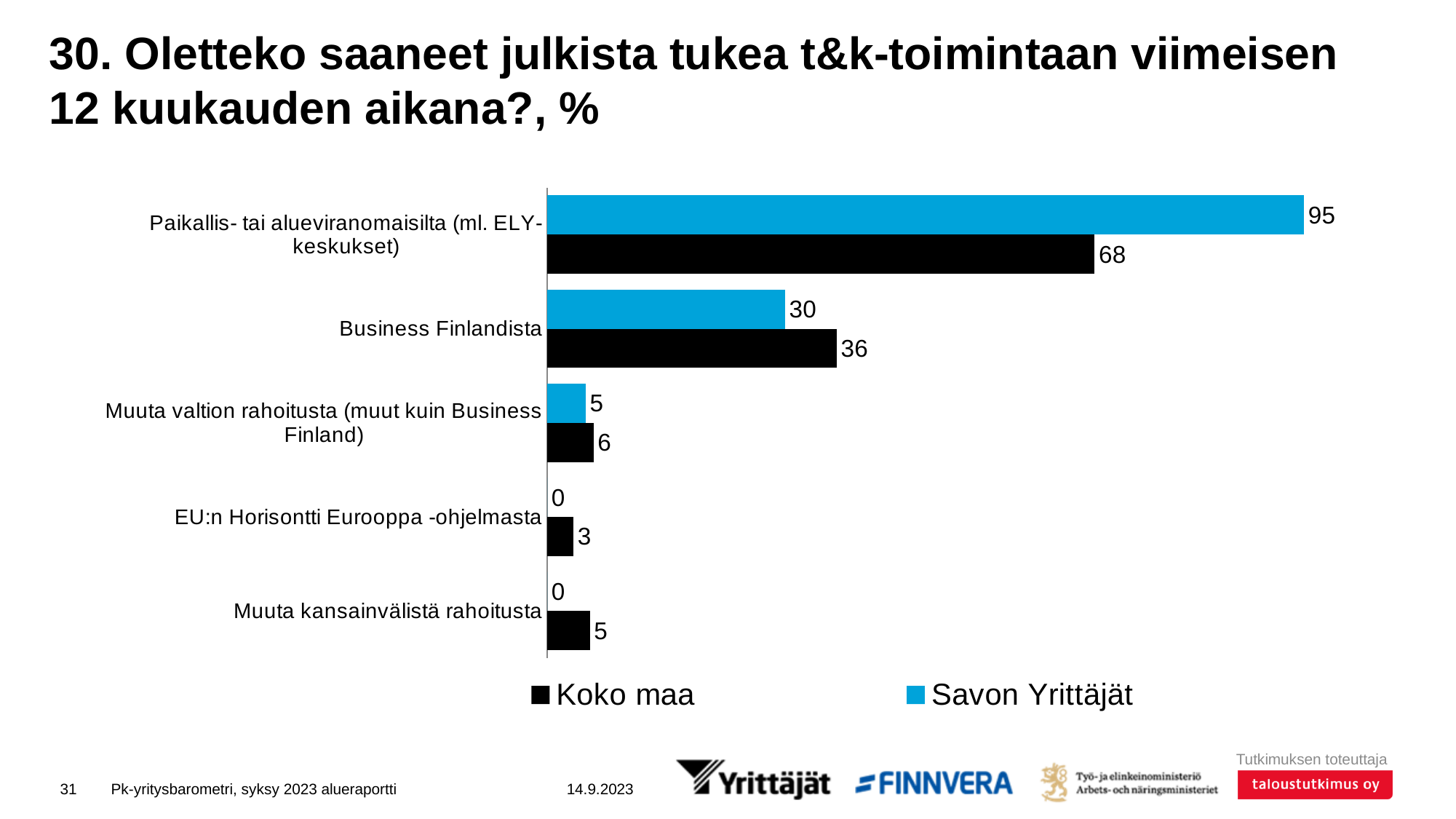
How many series does the legend list? 2 What is the value for Savon Yrittäjät for "EU:n Horisontti Eurooppa -ohjelmasta"? 0 What is the difference between the Savon Yrittäjät and Koko maa values for "Paikallis- tai alueviranomaisilta (ml. ELY-keskukset)"? 27 What is the value for Savon Yrittäjät for "Paikallis- tai alueviranomaisilta (ml. ELY-keskukset)"? 95 What kind of chart is shown on the slide? Bar chart For "Business Finlandista", which series has the larger value, Koko maa or Savon Yrittäjät? Koko maa Which colour represents Savon Yrittäjät in the chart? Blue What is the value for Koko maa for "Muuta kansainvälistä rahoitusta"? 5 Which category has the highest value for Koko maa? Paikallis- tai alueviranomaisilta (ml. ELY-keskukset) Which category has the lowest value for Koko maa? EU:n Horisontti Eurooppa -ohjelmasta What is the value for Koko maa for "Business Finlandista"? 36 How many categories are shown in the chart? 5